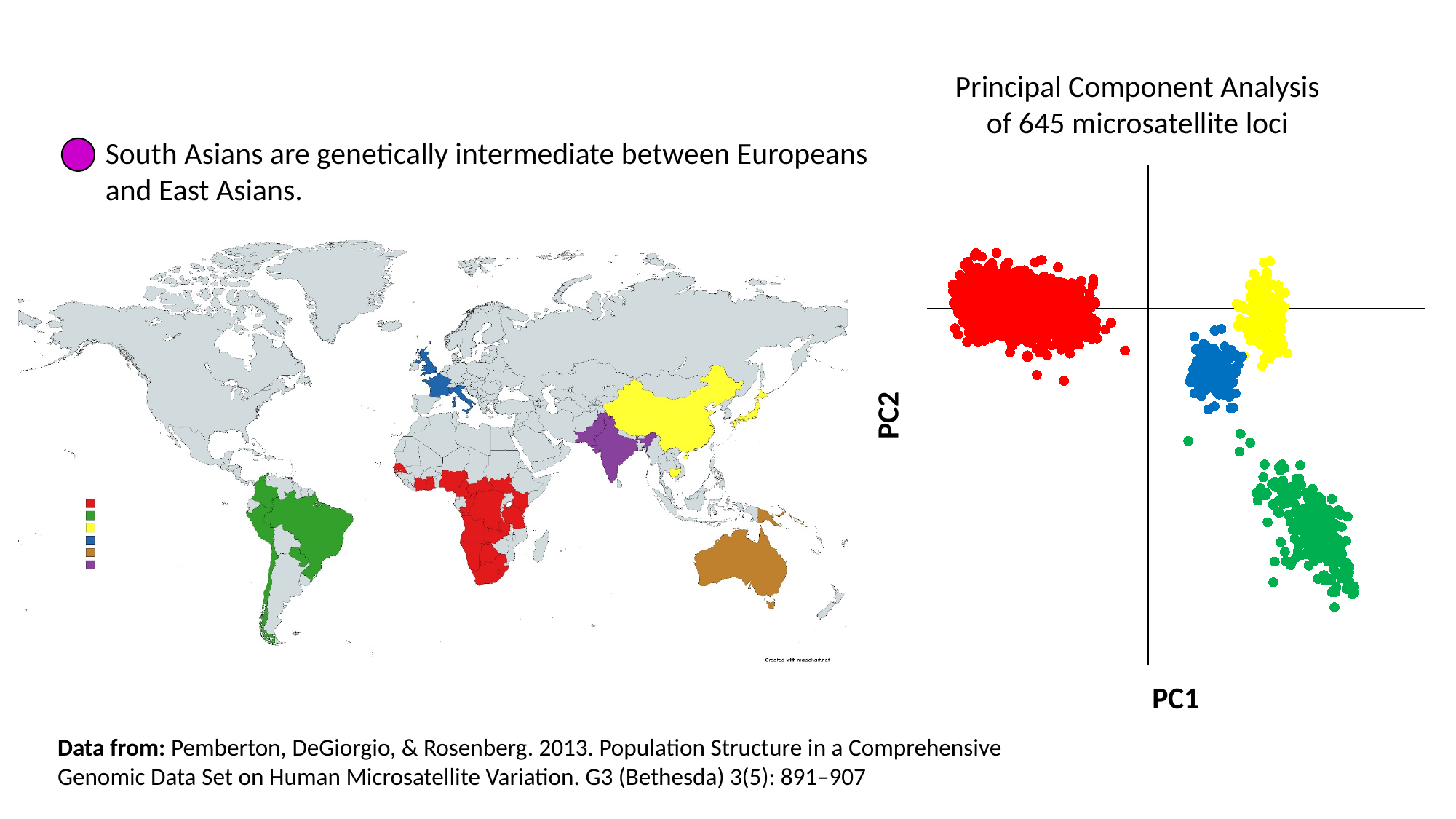
In the Principal Component Analysis chart, which coloured cluster is furthest left on the PC1 axis? red In the Principal Component Analysis chart, is the red cluster to the left or to the right of the yellow cluster on PC1? left In the Principal Component Analysis chart, is the PC2 value of the green cluster greater or less than zero (the horizontal axis line)? less In the Principal Component Analysis chart, is the PC1 value of the red cluster greater or less than zero (the vertical axis line)? less In the Principal Component Analysis chart, how many distinct coloured clusters of points are plotted? 4 What is the title of the chart on the right of the slide? Principal Component Analysis of 645 microsatellite loci In the Principal Component Analysis chart, is the blue cluster above or below the green cluster on PC2? above In the Principal Component Analysis chart, which coloured cluster extends furthest right on the PC1 axis? green What kind of chart is the 'Principal Component Analysis of 645 microsatellite loci' chart? scatter chart In the Principal Component Analysis chart, how many coloured clusters lie to the right of the vertical axis line? 3 In the Principal Component Analysis chart, what are the labels of the horizontal and vertical axes? PC1 and PC2 In the Principal Component Analysis chart, which coloured cluster sits lowest on the PC2 axis? green